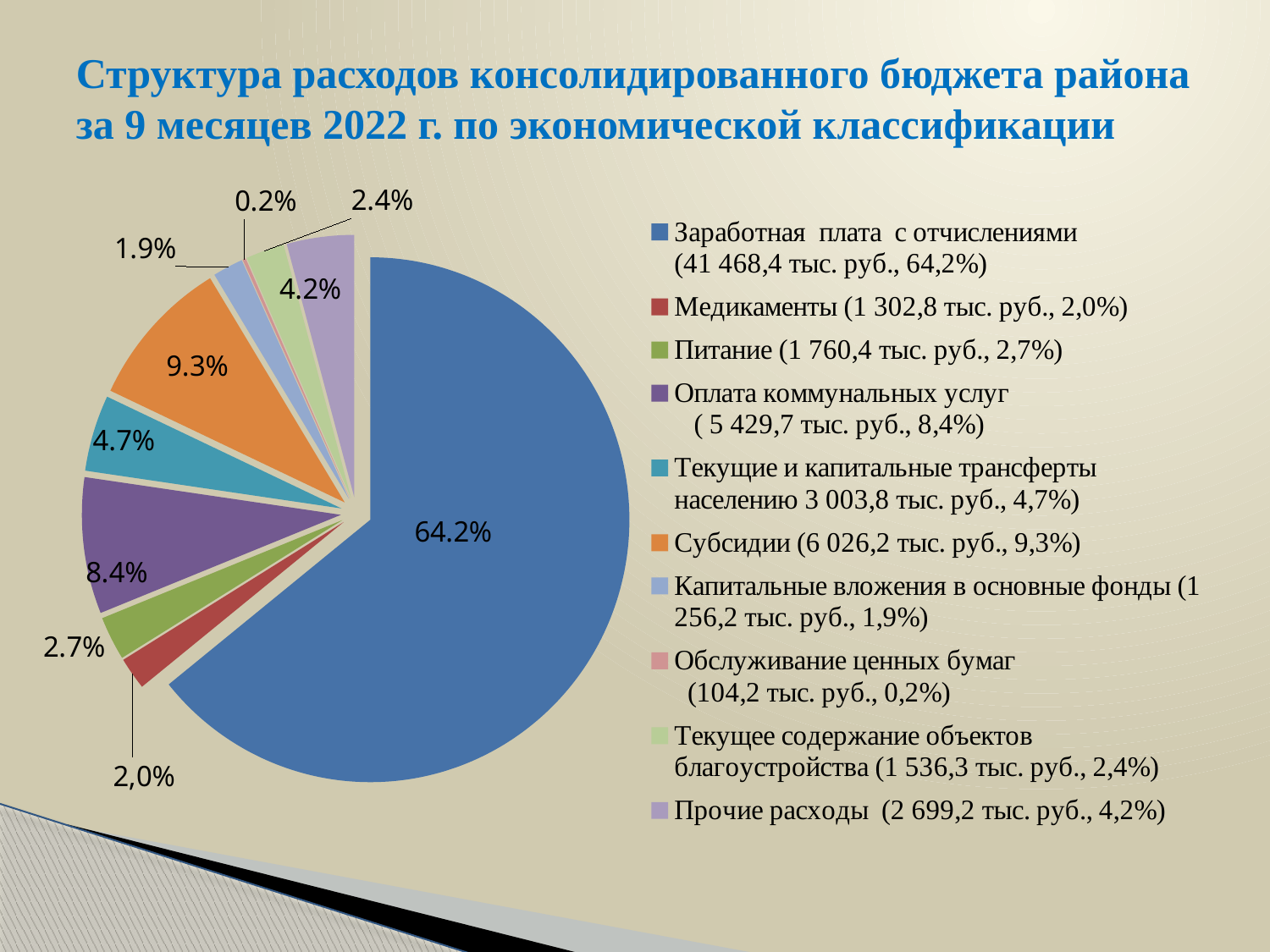
Which is larger: the share for "Субсидии" or the share for "Оплата коммунальных услуг"? Субсидии Which category has the smallest share of the pie? Обслуживание ценных бумаг According to the legend, what is the amount in thousand rubles for "Заработная плата с отчислениями"? 41 468,4 тыс. руб. What type of chart is shown on the slide? pie chart What percentage is shown for "Субсидии"? 9.3% According to the legend, what is the amount in thousand rubles for "Медикаменты"? 1 302,8 тыс. руб. What colour is the slice for "Заработная плата с отчислениями"? blue What percentage is shown for "Оплата коммунальных услуг"? 8.4% How many slices does the pie chart have? 10 What share of the pie does "Заработная плата с отчислениями" take? 64.2% What is the difference in percentage points between "Прочие расходы" (4.2%) and "Питание" (2.7%)? 1.5 Which category has the largest share of the pie? Заработная плата с отчислениями